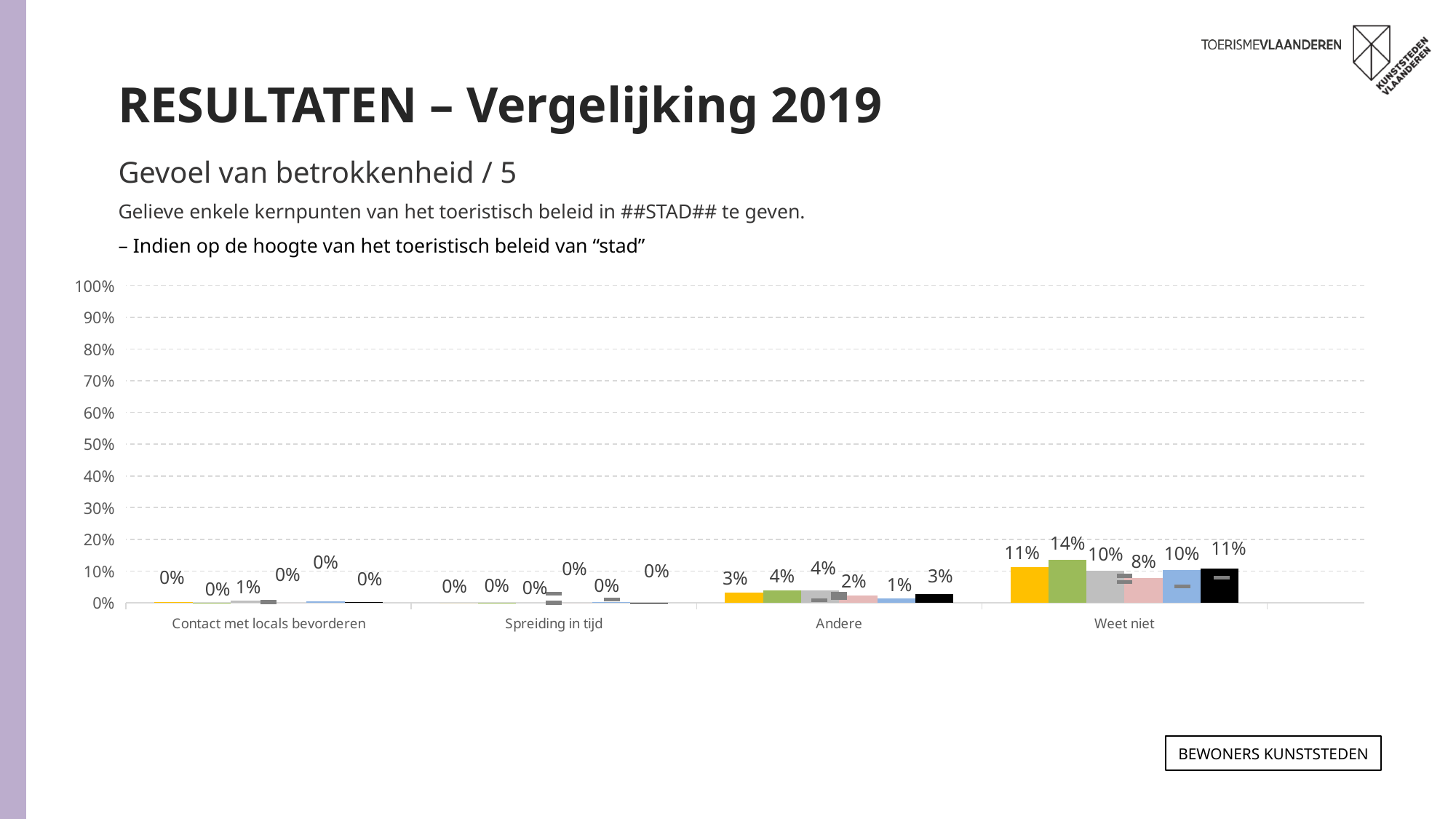
What is the value of the green bar for 'Weet niet'? 14% What is the value of the pink bar for 'Weet niet'? 8% What is the difference between the green bar and the pink bar for 'Weet niet'? 6% Which category has the highest values overall in the chart? Weet niet What is the value of the blue bar for 'Andere'? 1% Is the value of the green bar for 'Weet niet' greater or less than 10%? greater Within 'Weet niet', which coloured bar is the highest? green What is the value of the black bar for 'Andere'? 3% What kind of chart is shown on the slide? bar chart How many categories are shown on the x axis of the chart? 4 What is the value of the yellow bar for 'Weet niet'? 11% Is the green bar for 'Weet niet' larger or smaller than the black bar for 'Weet niet'? larger